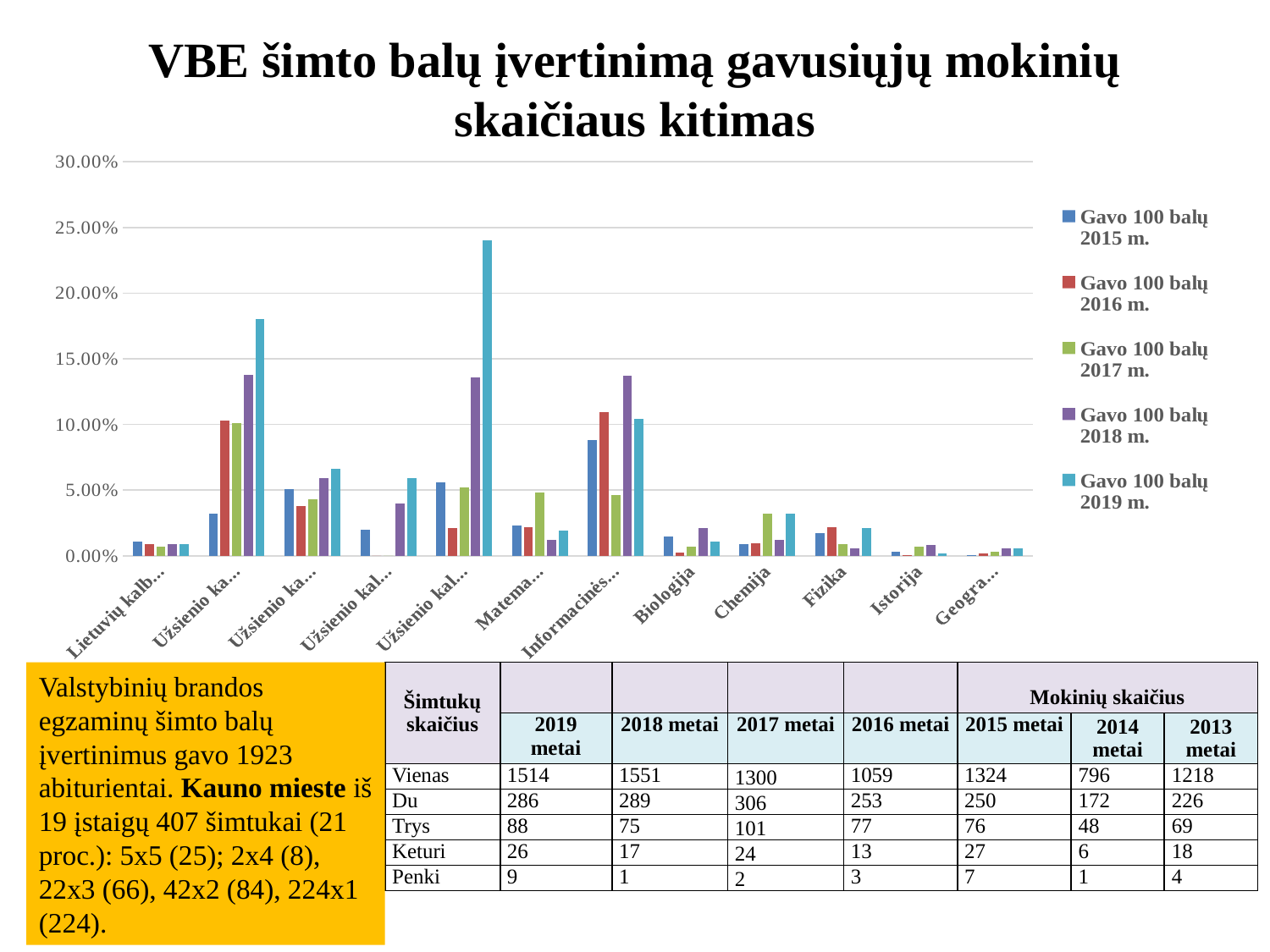
Is the value for Fizika in the series Gavo 100 balų 2016 m. greater or less than 10.00%? less How many subject categories are plotted along the x axis of the chart? 12 For Fizika, which is larger: the value for Gavo 100 balų 2016 m. or the value for Gavo 100 balų 2018 m.? Gavo 100 balų 2016 m. What kind of chart is shown on the slide? bar chart For Chemija, which is larger: the value for Gavo 100 balų 2017 m. or the value for Gavo 100 balų 2015 m.? Gavo 100 balų 2017 m. What is the title of the chart? VBE šimto balų įvertinimą gavusiųjų mokinių skaičiaus kitimas Is the value for Chemija in the series Gavo 100 balų 2017 m. greater or less than 5.00%? less How many series does the chart legend list? 5 For Biologija, which is larger: the value for Gavo 100 balų 2018 m. or the value for Gavo 100 balų 2016 m.? Gavo 100 balų 2018 m. Is the value for Biologija in the series Gavo 100 balų 2019 m. greater or less than 5.00%? less Which series does the legend list last? Gavo 100 balų 2019 m.